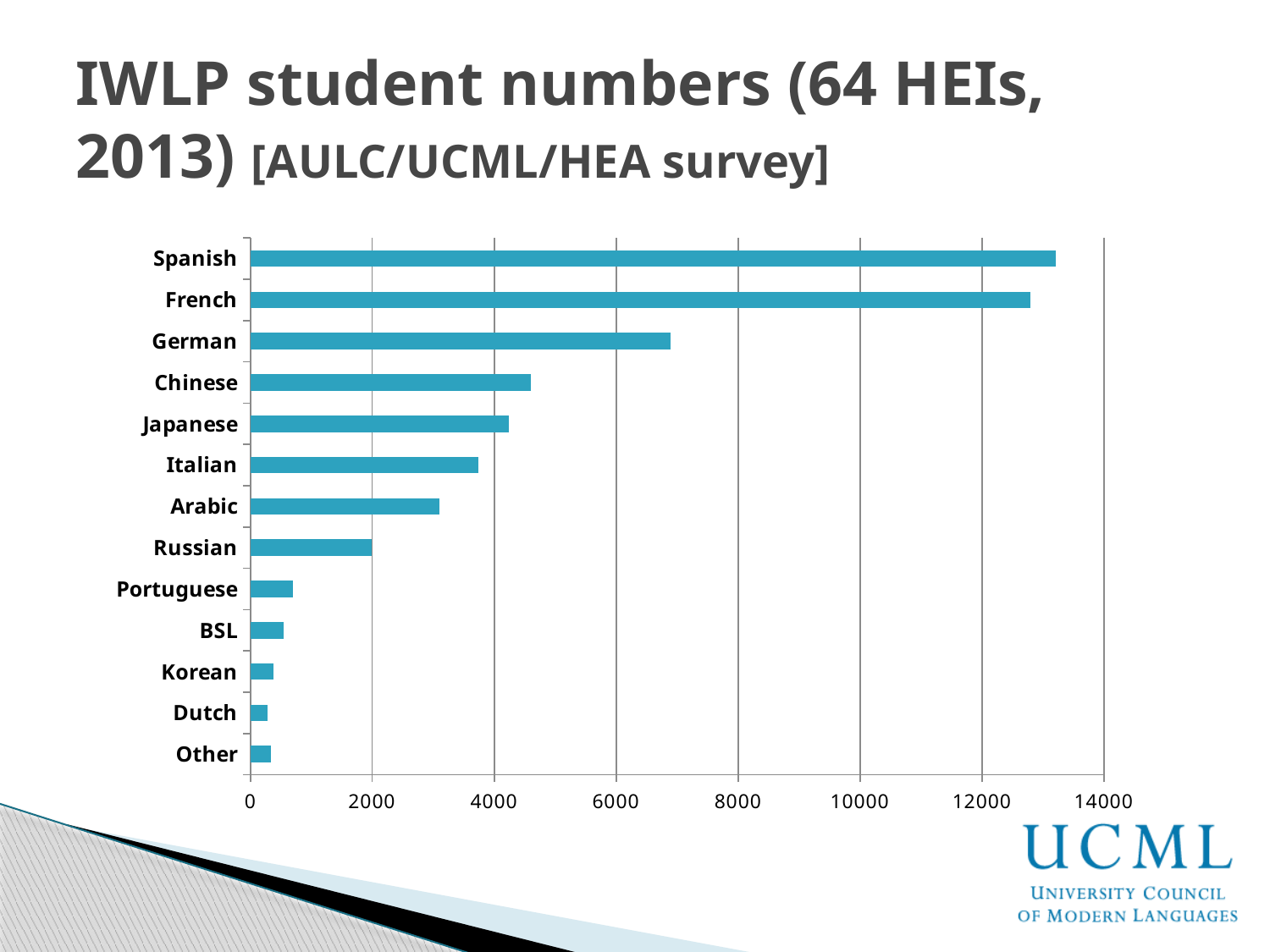
What is the title of the slide containing the chart? IWLP student numbers (64 HEIs, 2013) [AULC/UCML/HEA survey] Is the value for Portuguese greater or less than 2000? less Is the value for German greater or less than 6000? greater Is the value for Italian greater or less than 4000? less How many language categories are plotted in the chart? 13 What kind of chart is shown on the slide? bar chart Which has the larger value, German or Chinese? German Which has the larger value, Arabic or Russian? Arabic Which language has the highest IWLP student number? Spanish